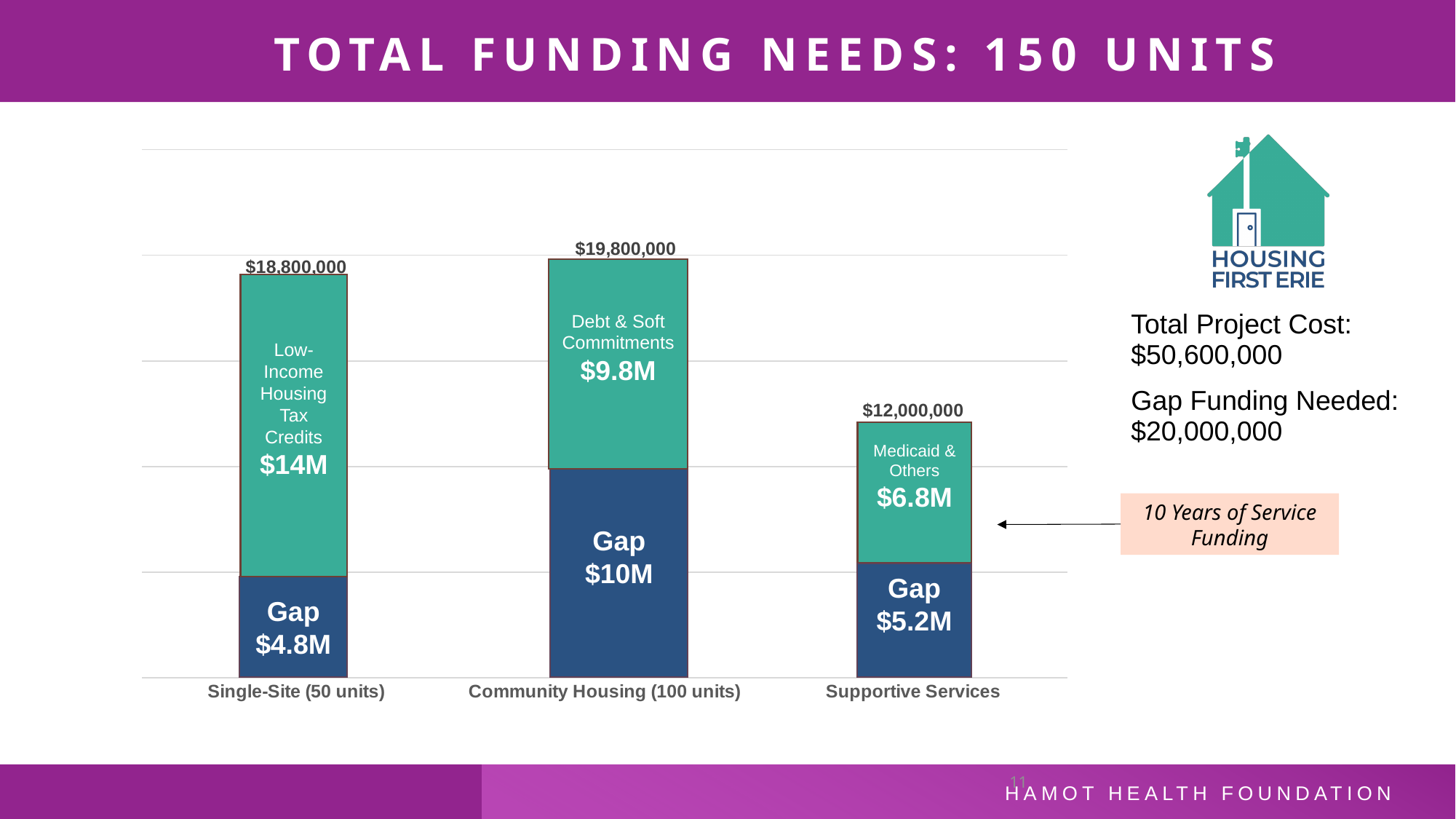
Which category has the lowest total funding need? Supportive Services What is the total printed above the Community Housing (100 units) bar? $19,800,000 Which category has the highest total funding need? Community Housing (100 units) What is the Medicaid & Others value for Supportive Services? $6.8M What is the Gap value for the Single-Site (50 units) bar? $4.8M What is the Low-Income Housing Tax Credits value for Single-Site (50 units)? $14M What kind of chart is shown on the slide? Stacked bar chart Which has the larger Gap value, Community Housing (100 units) or Supportive Services? Community Housing (100 units) What is the total printed above the Supportive Services bar? $12,000,000 What is the Debt & Soft Commitments value for Community Housing (100 units)? $9.8M What is the difference between the Gap values for Community Housing (100 units) and Single-Site (50 units)? $5.2M How many categories are shown on the x axis? 3